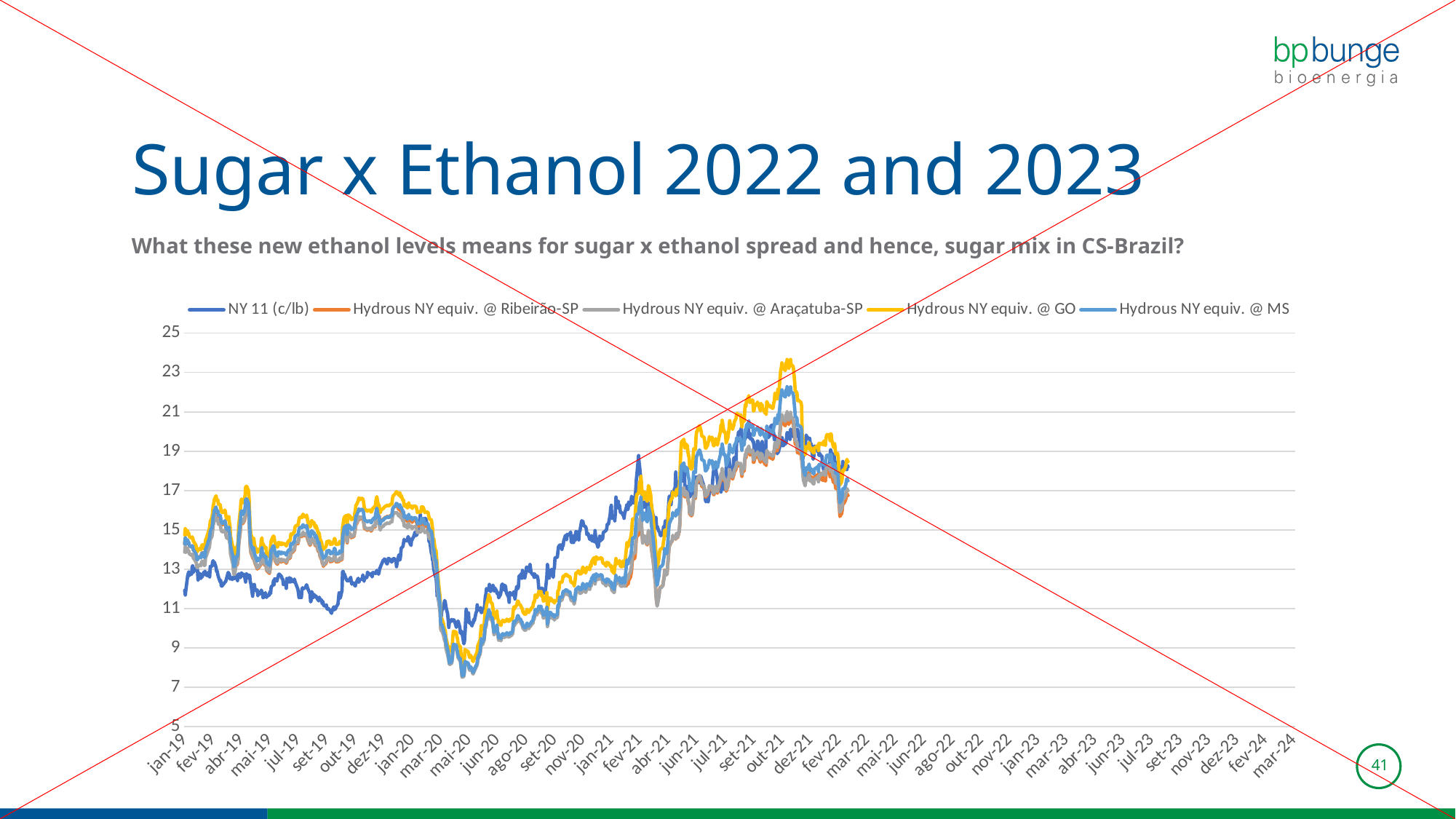
Around mai-20, which is higher: NY 11 (c/lb) or Hydrous NY equiv. @ Ribeirão-SP? NY 11 (c/lb) Is the lowest value of the Hydrous NY equiv. series around mai-20 greater or less than 9? less Which series is drawn in yellow? Hydrous NY equiv. @ GO At jan-19, which is higher: NY 11 (c/lb) or Hydrous NY equiv. @ GO? Hydrous NY equiv. @ GO What kind of chart is shown on the slide? line chart Do the series generally rise or fall between mai-20 and dez-21? rise Which series reaches the highest value on the chart, around out-21 to dez-21? Hydrous NY equiv. @ GO How many series does the legend list? 5 What is the highest value shown on the vertical axis? 25 What is the name of the first series in the legend? NY 11 (c/lb) Is the peak value of the Hydrous NY equiv. @ GO series around late 2021 greater or less than 21? greater